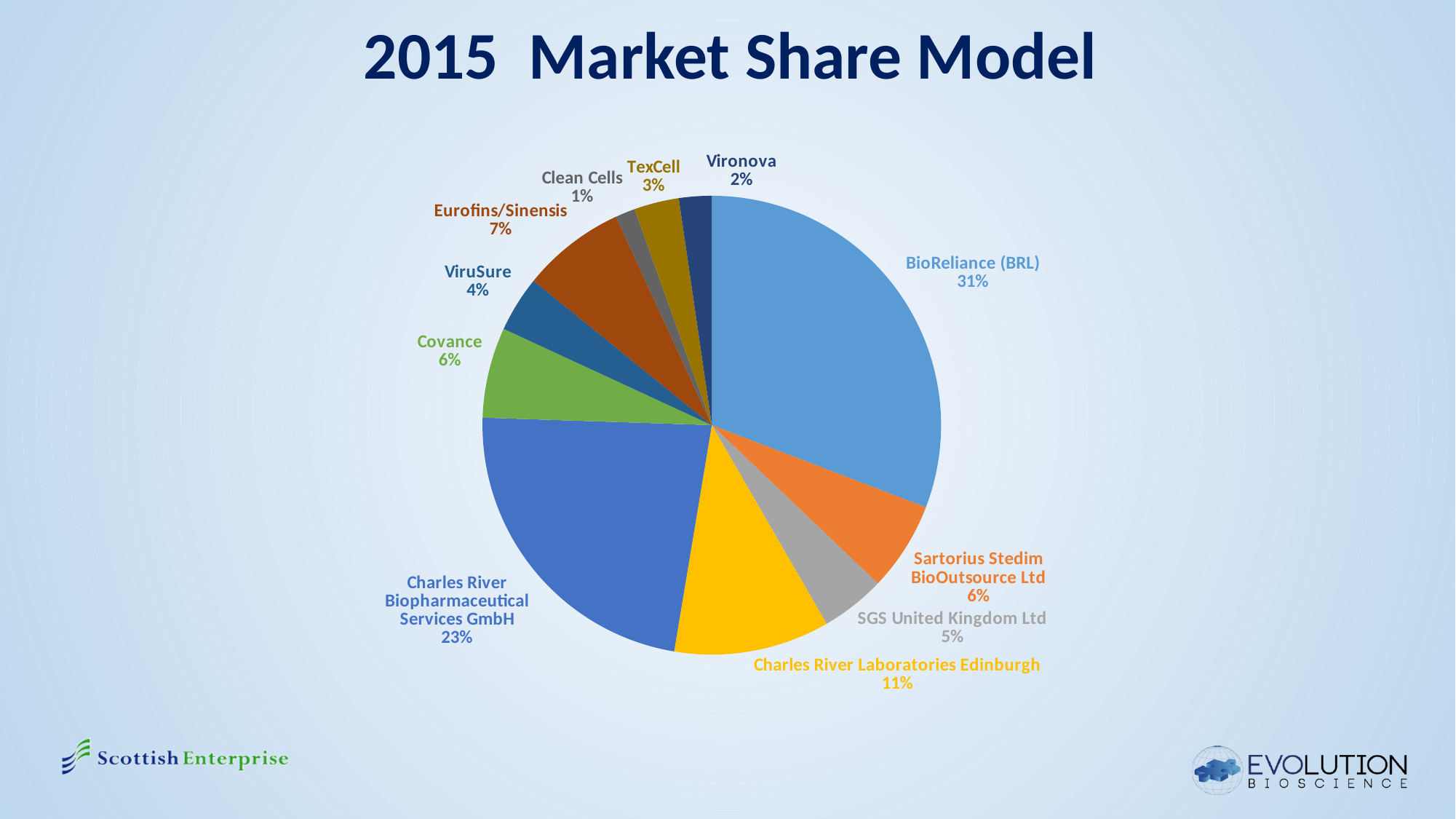
What kind of chart is shown on the slide? pie chart Which company has the smallest market share? Clean Cells What is the market share of BioReliance (BRL)? 31% What is the market share of Charles River Biopharmaceutical Services GmbH? 23% What is the market share of Eurofins/Sinensis? 7% What is the market share of Charles River Laboratories Edinburgh? 11% How many companies are shown in the pie chart? 11 What is the difference in market share between BioReliance (BRL) and Charles River Biopharmaceutical Services GmbH? 8% What is the title of the chart? 2015 Market Share Model Which company has the largest market share? BioReliance (BRL) Which has a larger market share, Covance or ViruSure? Covance What is the market share of SGS United Kingdom Ltd? 5%